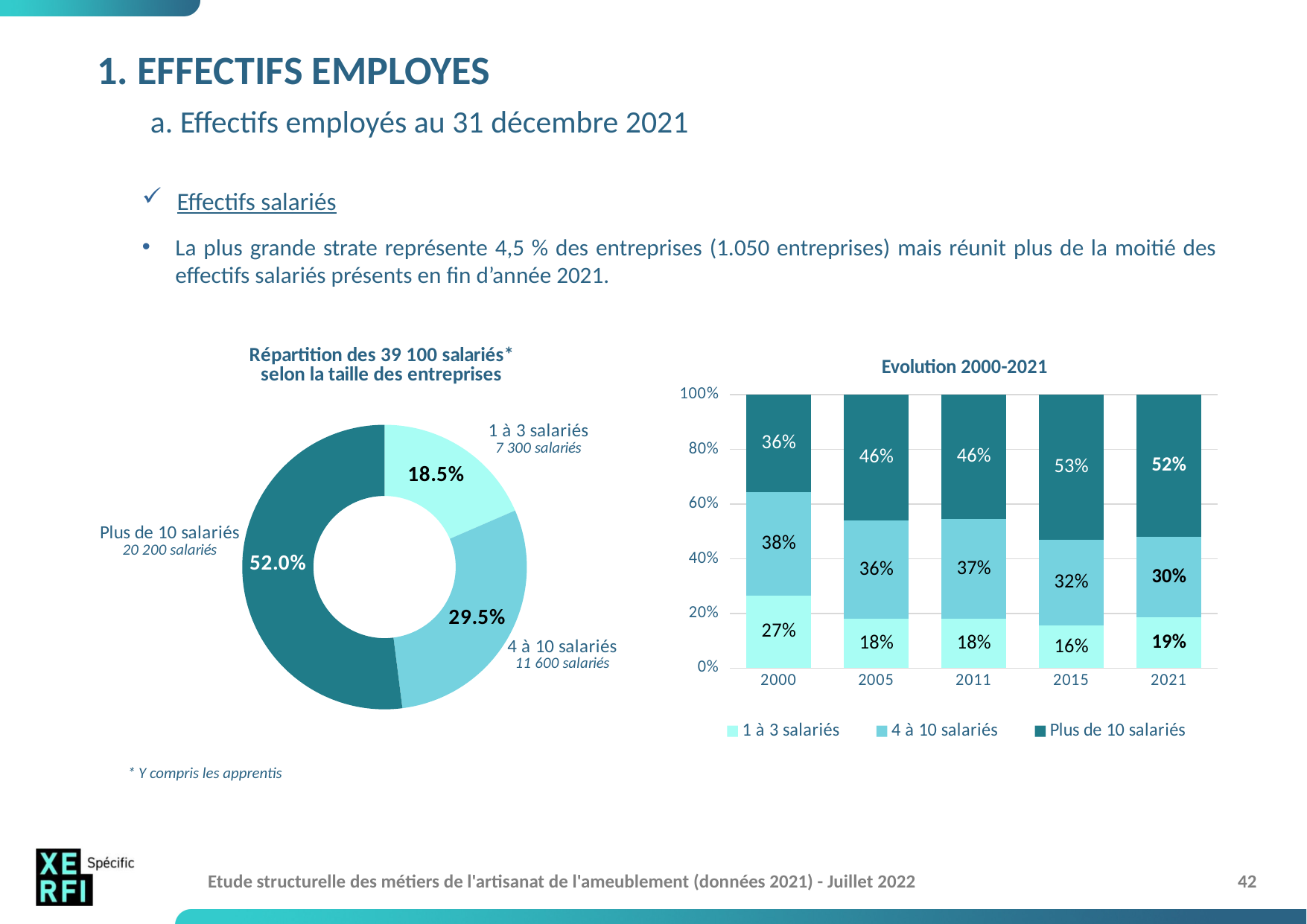
In the chart titled 'Répartition des 39 100 salariés selon la taille des entreprises', what share of employees is in the 'Plus de 10 salariés' category? 52.0% In the chart titled 'Evolution 2000-2021', how many series does the legend list? 3 In the chart titled 'Evolution 2000-2021', what is the value for '1 à 3 salariés' in 2000? 27% In the chart titled 'Evolution 2000-2021', how many years are shown on the x axis? 5 In the chart titled 'Répartition des 39 100 salariés selon la taille des entreprises', which category has the smallest share? 1 à 3 salariés In the chart titled 'Evolution 2000-2021', what is the value for 'Plus de 10 salariés' in 2015? 53% What kind of chart is the one titled 'Répartition des 39 100 salariés selon la taille des entreprises'? Pie (donut) chart In the chart titled 'Répartition des 39 100 salariés selon la taille des entreprises', how many categories are shown? 3 In the chart titled 'Evolution 2000-2021', is the '4 à 10 salariés' share larger in 2000 or in 2021? 2000 In the chart titled 'Evolution 2000-2021', in which year is the '1 à 3 salariés' share lowest? 2015 In the chart titled 'Répartition des 39 100 salariés selon la taille des entreprises', how many employees are in the '4 à 10 salariés' category? 11 600 salariés In the chart titled 'Evolution 2000-2021', what is the difference between the 'Plus de 10 salariés' share in 2021 and in 2000? 16 percentage points